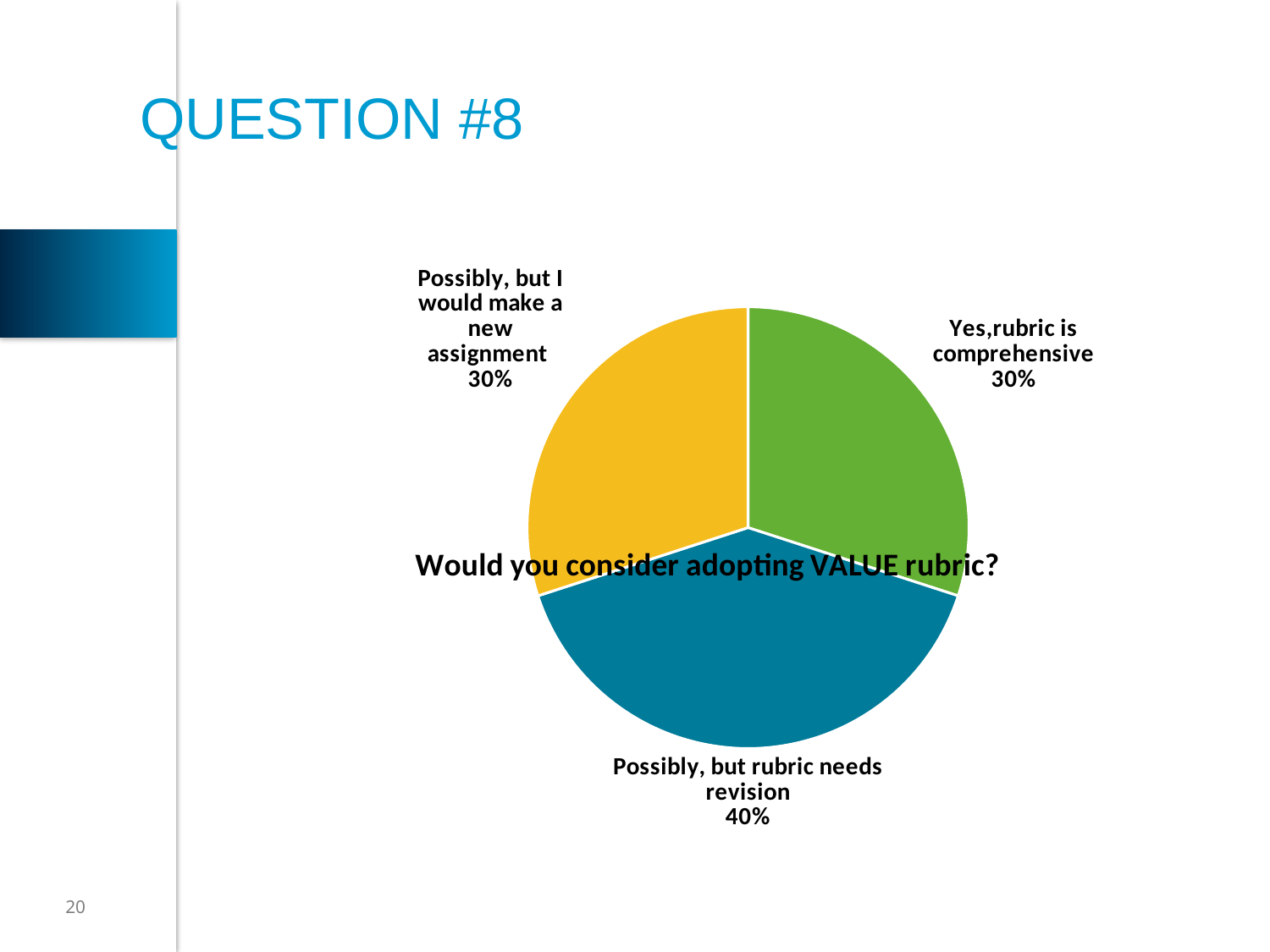
What is the difference in percentage points between 'Possibly, but rubric needs revision' and 'Yes, rubric is comprehensive'? 10% What is the title of the pie chart? Would you consider adopting VALUE rubric? What share of the pie is 'Possibly, but rubric needs revision'? 40% What share of the pie is 'Possibly, but I would make a new assignment'? 30% What kind of chart is shown on the slide? pie chart What colour is the slice for 'Possibly, but rubric needs revision'? teal blue What is the combined share of the two 'Possibly' responses? 70% How many slices does the pie chart have? 3 Which response has the largest share of the pie? Possibly, but rubric needs revision What share of the pie is 'Yes, rubric is comprehensive'? 30% Which is larger: the share for 'Possibly, but rubric needs revision' or the share for 'Possibly, but I would make a new assignment'? Possibly, but rubric needs revision